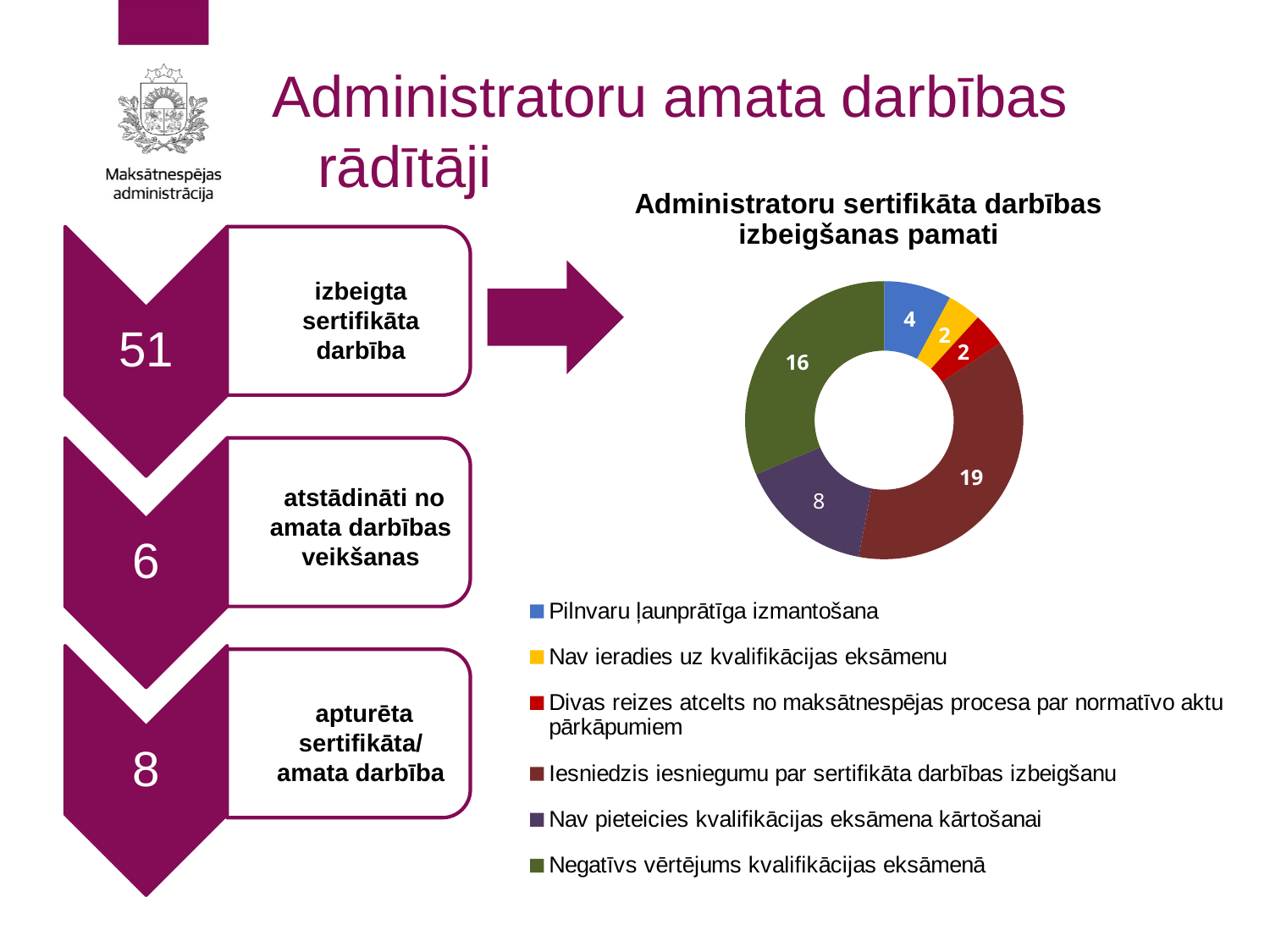
What is the value for "Nav pieteicies kvalifikācijas eksāmena kārtošanai" in the doughnut chart? 8 Which colour represents "Nav ieradies uz kvalifikācijas eksāmenu" in the doughnut chart? Yellow What is the total of all values shown in the doughnut chart? 51 What is the title of the doughnut chart? Administratoru sertifikāta darbības izbeigšanas pamati What is the value for "Iesniedzis iesniegumu par sertifikāta darbības izbeigšanu" in the doughnut chart? 19 Which category has the largest value in the doughnut chart? Iesniedzis iesniegumu par sertifikāta darbības izbeigšanu How many categories does the doughnut chart show? 6 What is the value for "Negatīvs vērtējums kvalifikācijas eksāmenā" in the doughnut chart? 16 What is the value for "Pilnvaru ļaunprātīga izmantošana" in the doughnut chart? 4 Which is larger in the doughnut chart: "Nav pieteicies kvalifikācijas eksāmena kārtošanai" or "Pilnvaru ļaunprātīga izmantošana"? Nav pieteicies kvalifikācijas eksāmena kārtošanai What type of chart is shown under the title "Administratoru sertifikāta darbības izbeigšanas pamati"? Doughnut (pie) chart What is the difference between the values for "Iesniedzis iesniegumu par sertifikāta darbības izbeigšanu" and "Negatīvs vērtējums kvalifikācijas eksāmenā"? 3